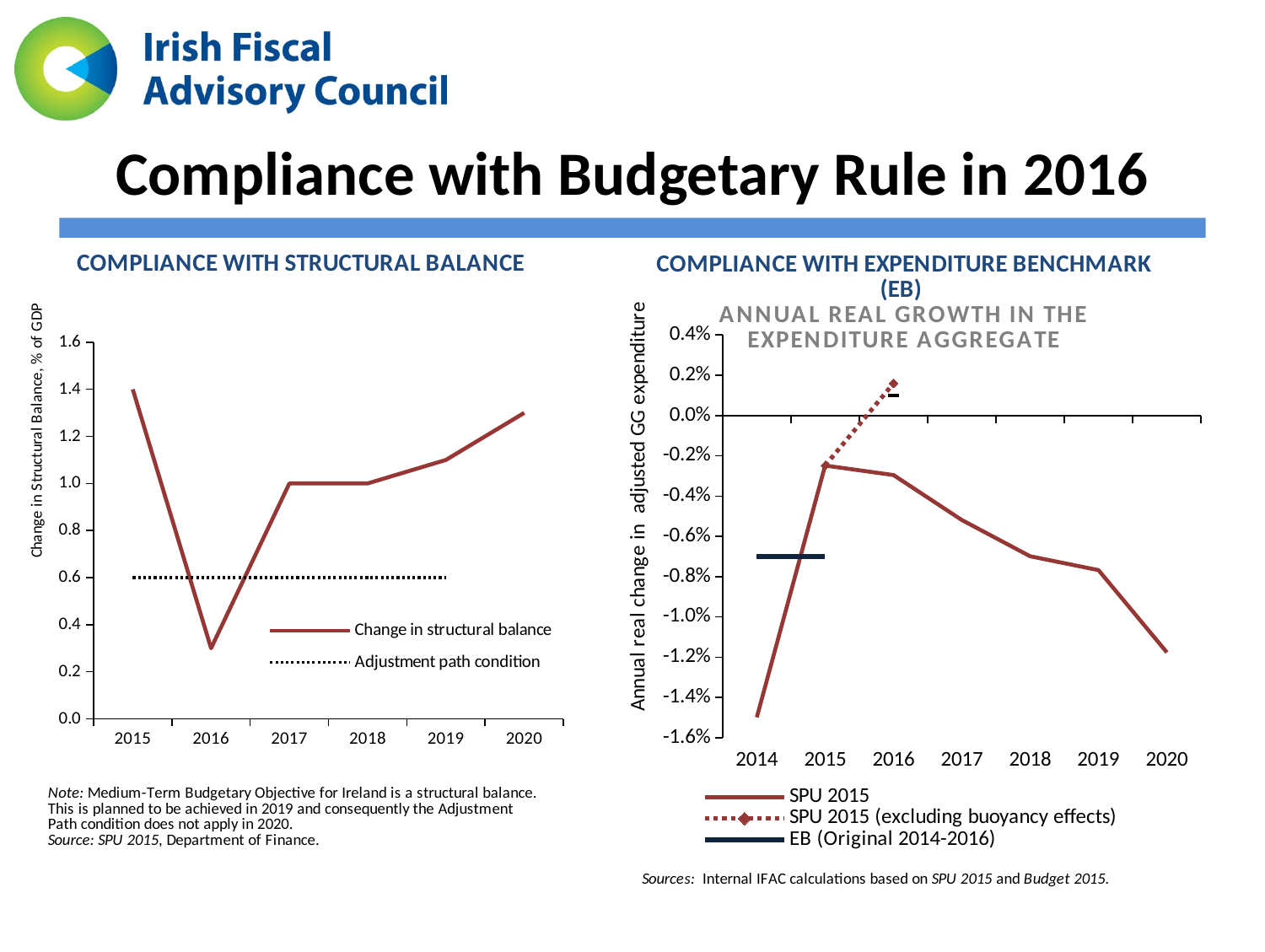
On the Compliance with Expenditure Benchmark (EB) chart, is the SPU 2015 value for 2020 greater or less than -1.0%? less On the Compliance with Structural Balance chart, how many series does the legend list? 2 On the Compliance with Structural Balance chart, which is larger: the change in structural balance in 2016 or in 2019? 2019 On the Compliance with Expenditure Benchmark (EB) chart, how many series does the legend list? 3 On the Compliance with Structural Balance chart, in which year is the change in structural balance highest? 2015 On the Compliance with Structural Balance chart, what kind of chart is it? line chart On the Compliance with Expenditure Benchmark (EB) chart, does the SPU 2015 series rise or fall from 2016 to 2020? fall On the Compliance with Structural Balance chart, is the change in structural balance for 2016 greater or less than 0.4? less On the Compliance with Structural Balance chart, in which year is the change in structural balance lowest? 2016 On the Compliance with Expenditure Benchmark (EB) chart, in which year is the SPU 2015 series lowest? 2014 On the Compliance with Structural Balance chart, how many years are shown on the x axis? 6 On the Compliance with Expenditure Benchmark (EB) chart, what kind of chart is it? line chart